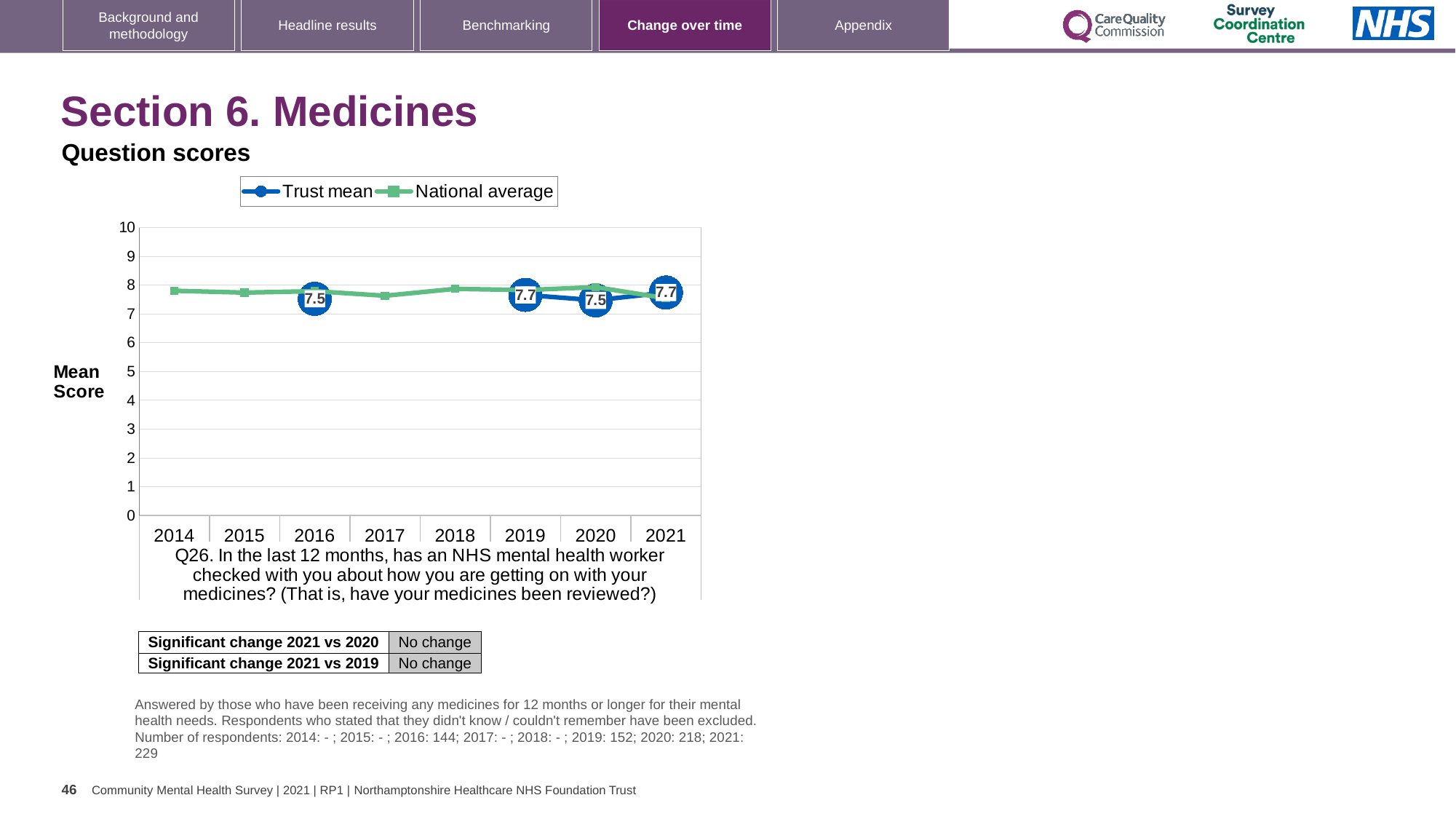
What is the Trust mean score for 2019? 7.7 How many series does the legend list? 2 What is the Trust mean score for 2021? 7.7 What are the two series named in the legend? Trust mean and National average How many years are shown on the x axis? 8 What is the Trust mean score for 2016? 7.5 Which year has the higher Trust mean score, 2019 or 2020? 2019 What kind of chart is shown on the slide? Line chart Is the National average value for 2014 greater or less than 5? greater What is the Trust mean score for 2020? 7.5 Between 2020 and 2021, does the Trust mean rise or fall? Rise What is the difference between the Trust mean scores for 2021 and 2020? 0.2